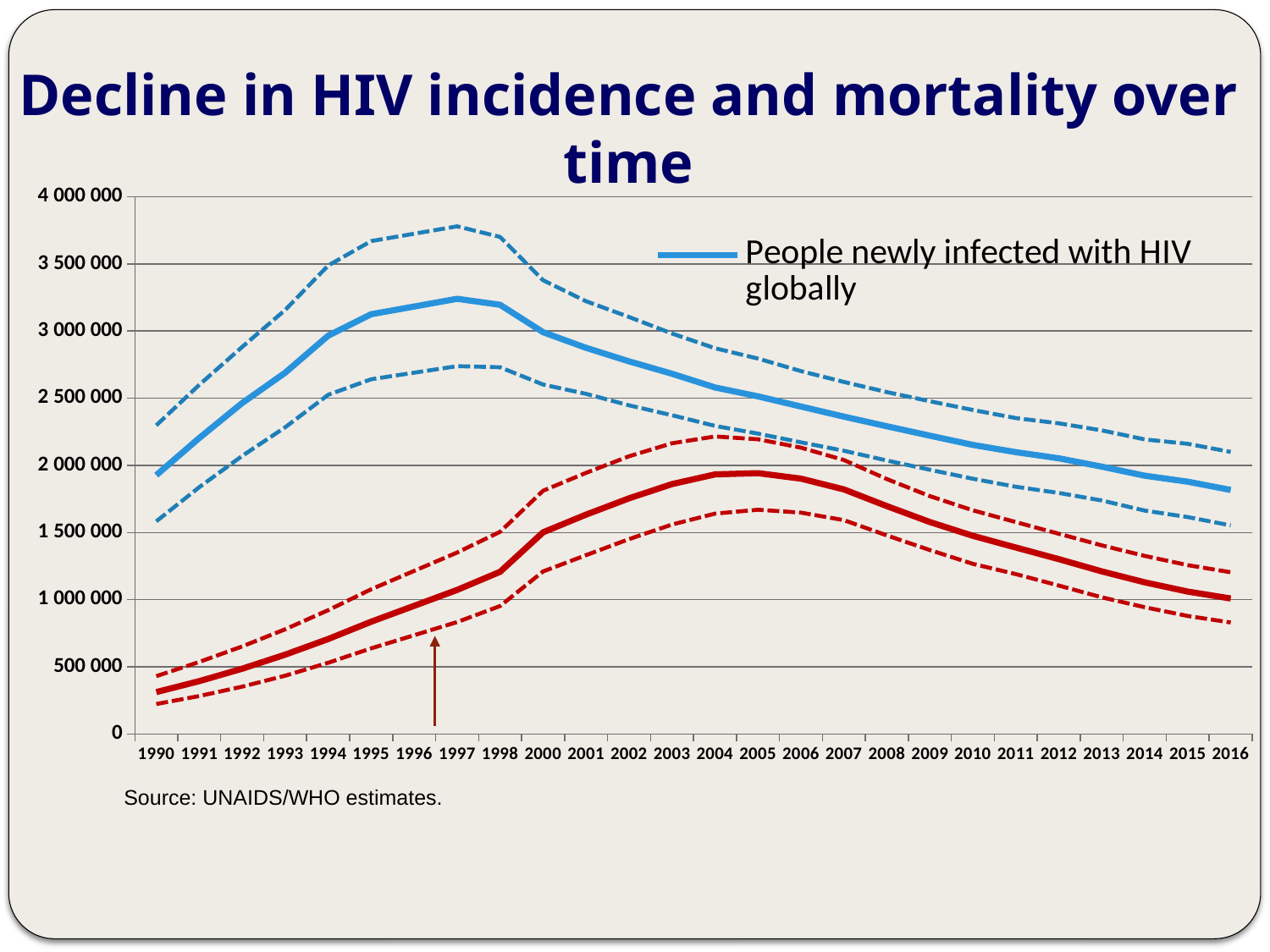
Is the value of the solid line for People newly infected with HIV globally in 1997 greater or less than 3 000 000? greater Is the value of the red solid line in 2005 greater or less than 1 500 000? greater In which year does the solid line for People newly infected with HIV globally reach its highest point? 1997 Does the solid line for People newly infected with HIV globally rise or fall between 1997 and 2016? Fall What is the legend entry for the blue solid line? People newly infected with HIV globally Is the value of the solid line for People newly infected with HIV globally in 2016 greater or less than 2 000 000? less How many year labels are shown on the x axis? 26 What kind of chart is shown on the slide? Line chart What is the title of the chart on the slide? Decline in HIV incidence and mortality over time How many series does the chart's legend list? 1